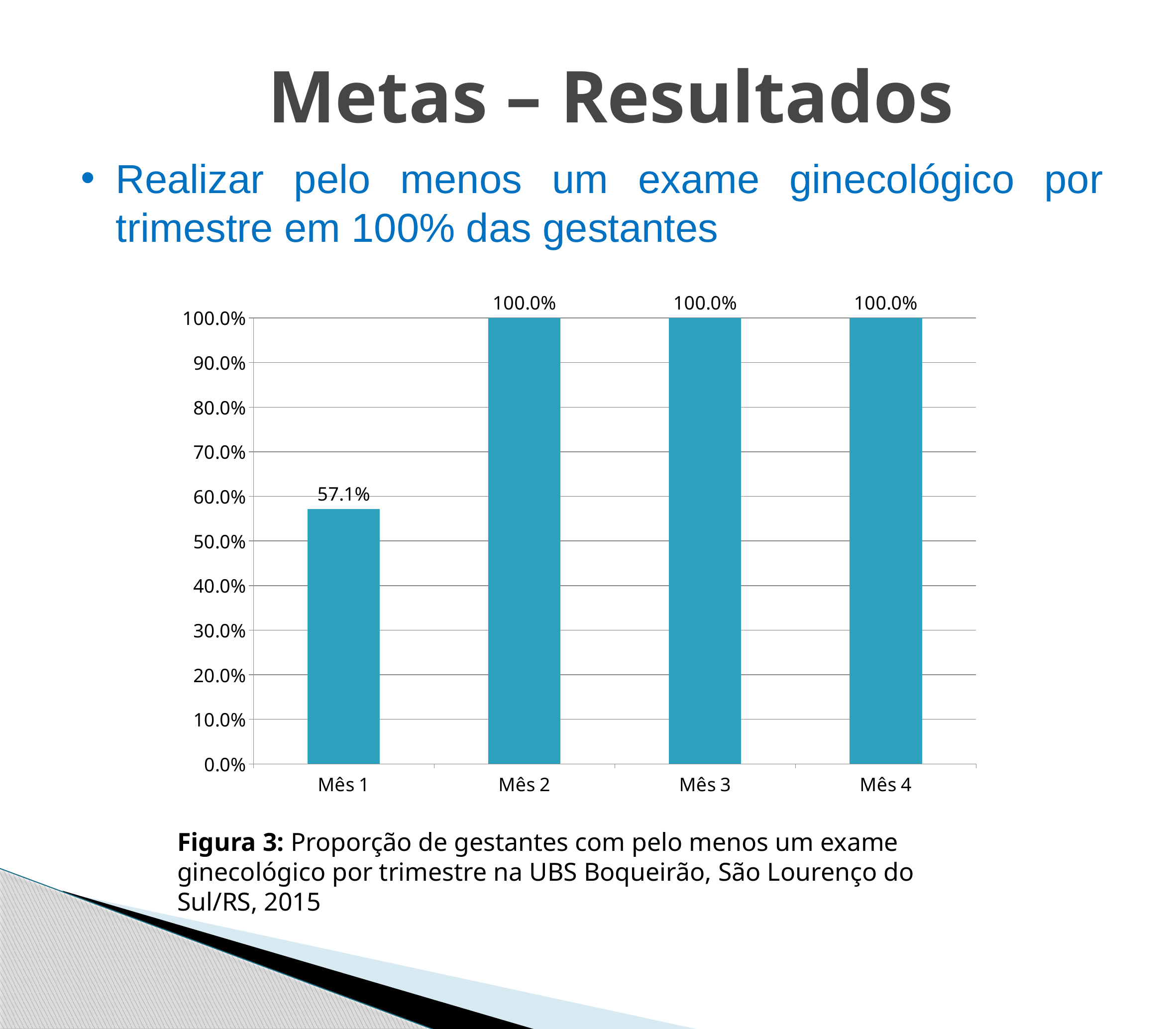
Which month has the lowest value? Mês 1 How many months reach 100.0%? 3 How many months are shown on the x axis? 4 What is the difference between the values for Mês 2 and Mês 1? 42.9% What kind of chart is shown on the slide? bar chart What is the value for Mês 4? 100.0% What is the value for Mês 1? 57.1% Do the values rise or fall from Mês 1 to Mês 2? rise Is the value for Mês 1 greater or less than 50.0%? greater What is the value for Mês 2? 100.0% Which is larger, the value for Mês 1 or the value for Mês 3? Mês 3 What is the figure number given in the caption below the chart? Figura 3